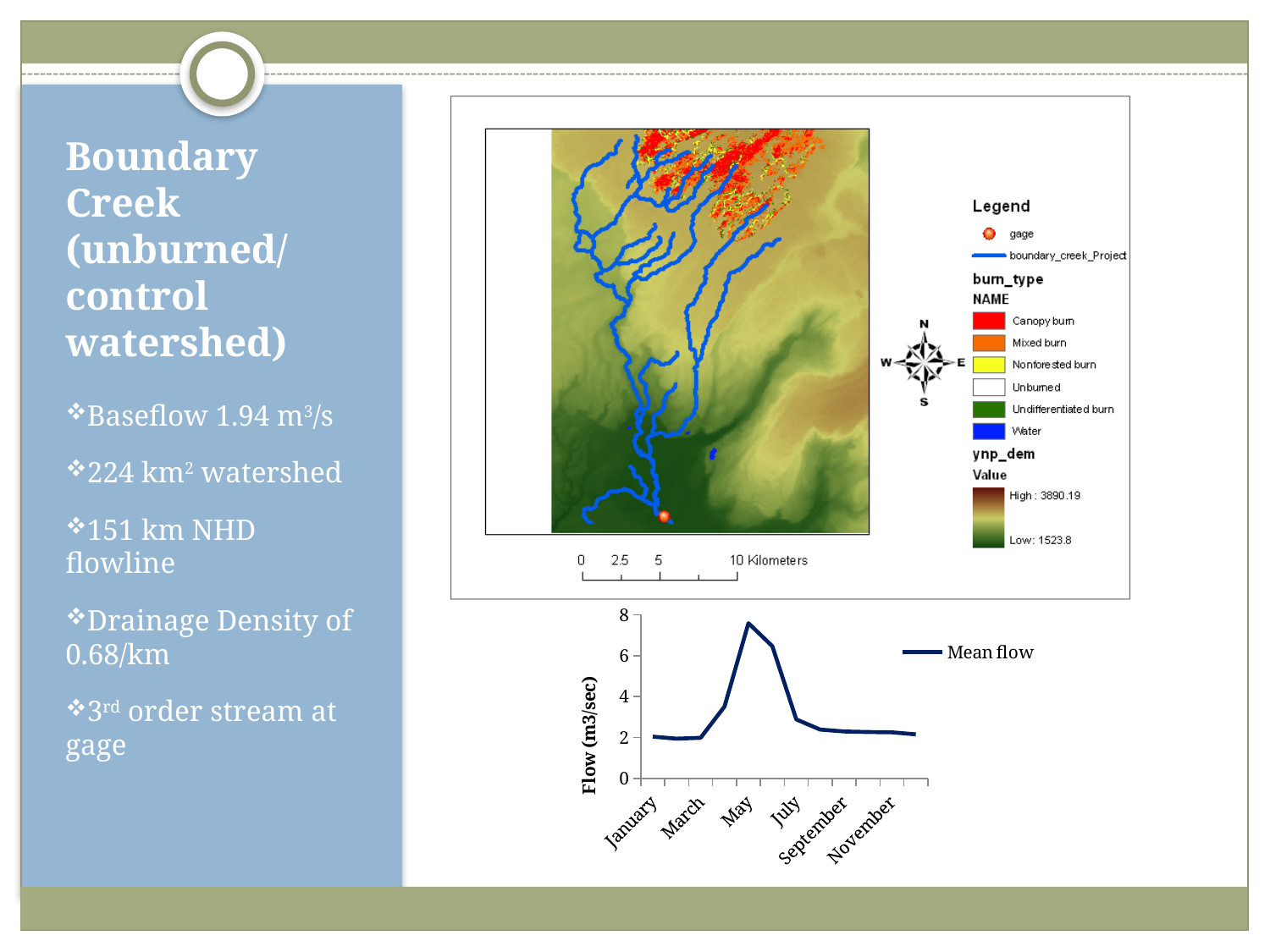
Which month has the larger Mean flow value, May or September? May Is the Mean flow value for May greater or less than 6? greater How many series does the legend of the line chart list? 1 Is the Mean flow value for January greater or less than 4? less What is the label on the vertical axis of the line chart? Flow (m3/sec) Is the Mean flow value for July greater or less than 4? less Does the Mean flow line rise or fall between May and July? fall What kind of chart is shown below the map on the slide? line chart Does the Mean flow line rise or fall between March and May? rise In which month does the Mean flow line reach its highest value? May What is the name of the series shown in the legend of the line chart? Mean flow